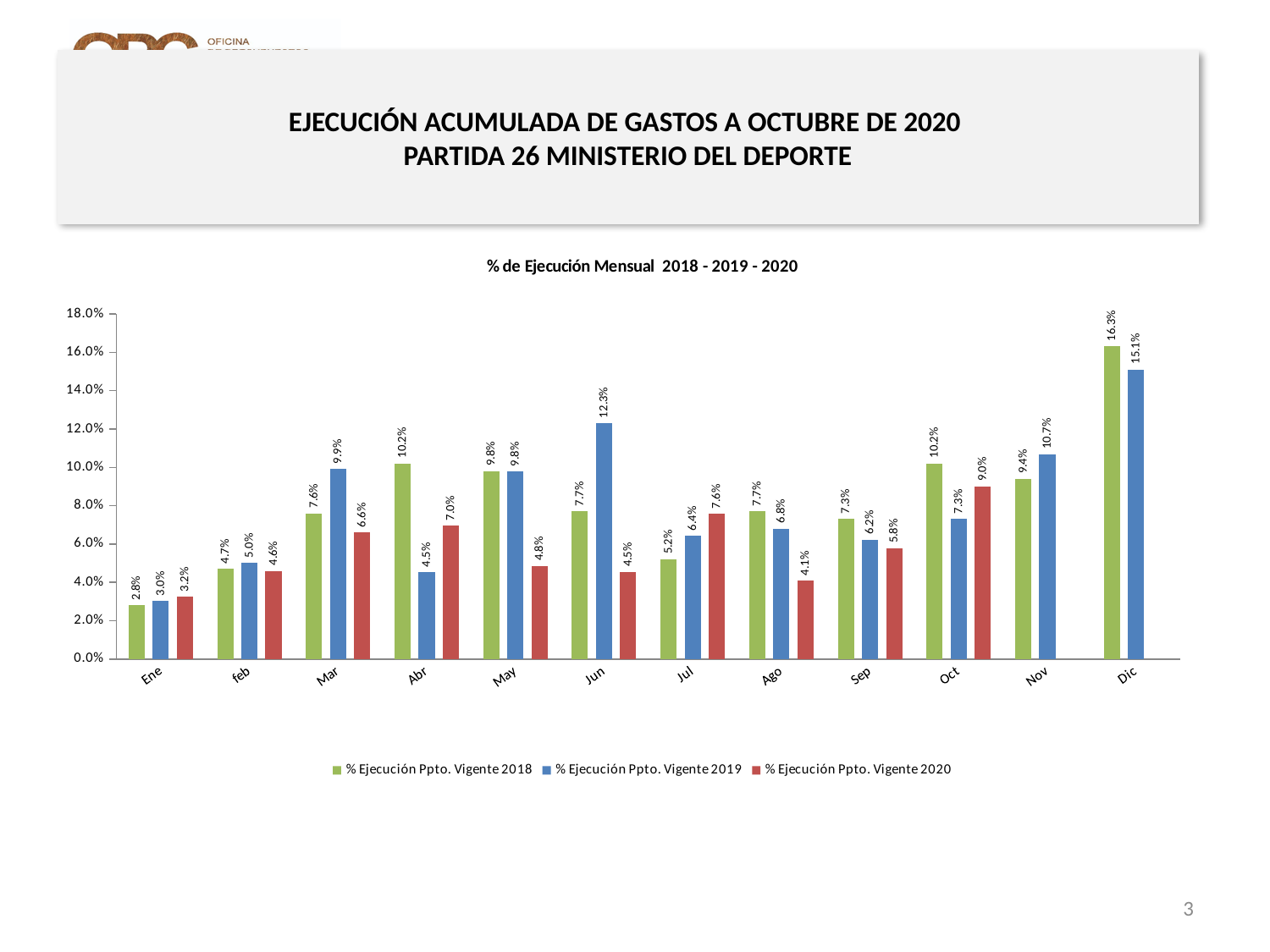
Which month has the highest value for % Ejecución Ppto. Vigente 2018? Dic How many months are shown on the x axis? 12 What type of chart is shown on the slide? bar chart What is the value for % Ejecución Ppto. Vigente 2020 in Oct? 9.0% Which month has the lowest value for % Ejecución Ppto. Vigente 2020? Ene What colour represents % Ejecución Ppto. Vigente 2019 in the chart? blue What is the value for % Ejecución Ppto. Vigente 2019 in Jun? 12.3% What is the value for % Ejecución Ppto. Vigente 2018 in Abr? 10.2% Is the value for % Ejecución Ppto. Vigente 2019 in Nov greater or less than 10.0%? greater What is the difference between the 2018 and 2019 values in Dic? 1.2% How many series does the legend list? 3 In Jul, which series has the larger value: % Ejecución Ppto. Vigente 2018 or % Ejecución Ppto. Vigente 2020? % Ejecución Ppto. Vigente 2020